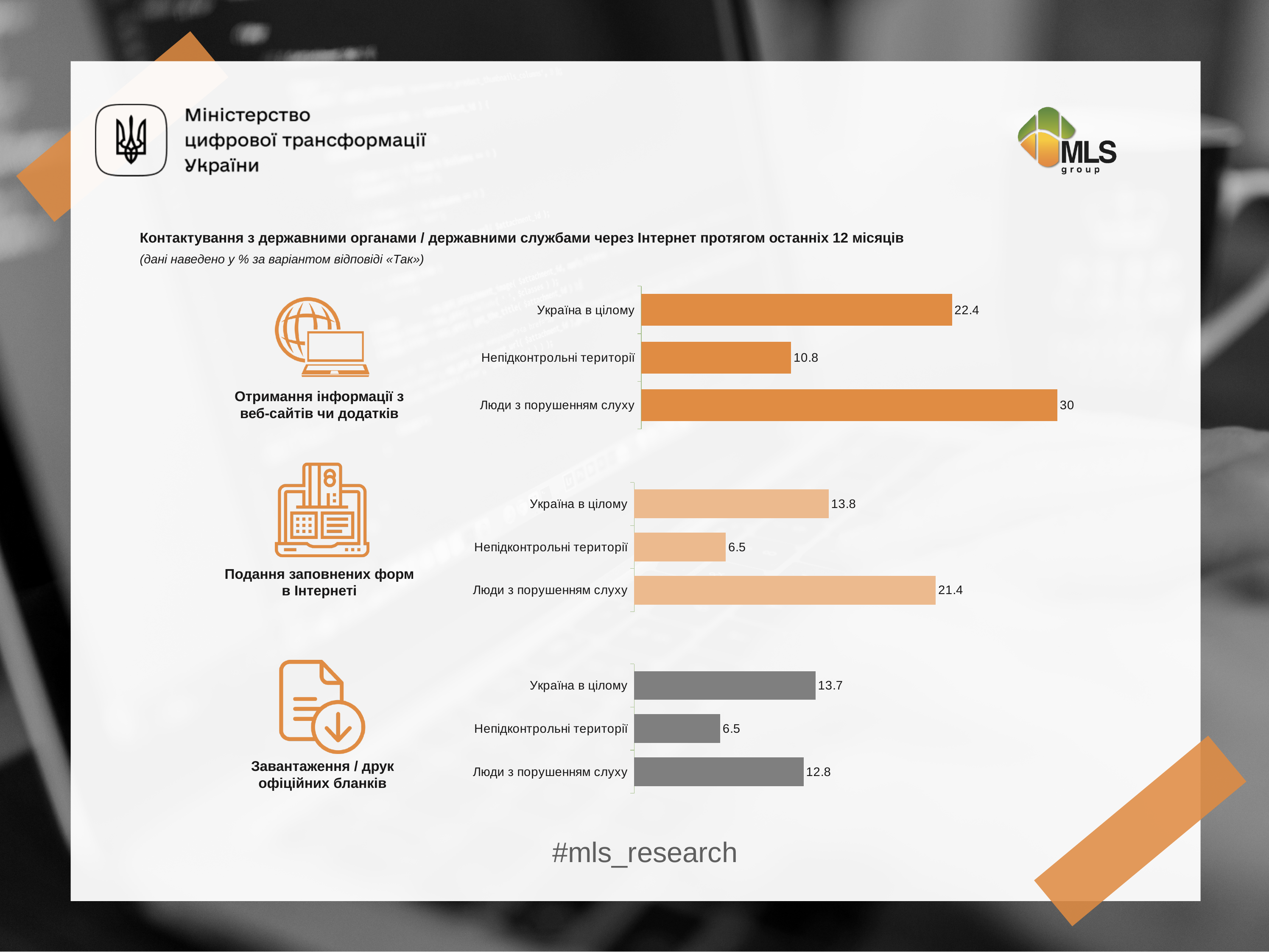
How many categories are shown in the chart "Отримання інформації з веб-сайтів чи додатків"? 3 In the chart "Завантаження / друк офіційних бланків", what is the difference between "Україна в цілому" and "Непідконтрольні території"? 7.2 In the chart "Подання заповнених форм в Інтернеті", which category has the lowest value? Непідконтрольні території In the chart "Отримання інформації з веб-сайтів чи додатків", which category has the highest value? Люди з порушенням слуху In the chart "Подання заповнених форм в Інтернеті", what is the value for "Непідконтрольні території"? 6.5 What type of chart is used for "Подання заповнених форм в Інтернеті"? Bar chart How many separate bar charts are shown on the slide? 3 In the chart "Подання заповнених форм в Інтернеті", which is larger: "Україна в цілому" or "Люди з порушенням слуху"? Люди з порушенням слуху In the chart "Завантаження / друк офіційних бланків", which category has the highest value? Україна в цілому In the chart "Отримання інформації з веб-сайтів чи додатків", what is the difference between "Люди з порушенням слуху" and "Непідконтрольні території"? 19.2 In the chart "Отримання інформації з веб-сайтів чи додатків", what is the value for "Україна в цілому"? 22.4 In the chart "Завантаження / друк офіційних бланків", what is the value for "Люди з порушенням слуху"? 12.8